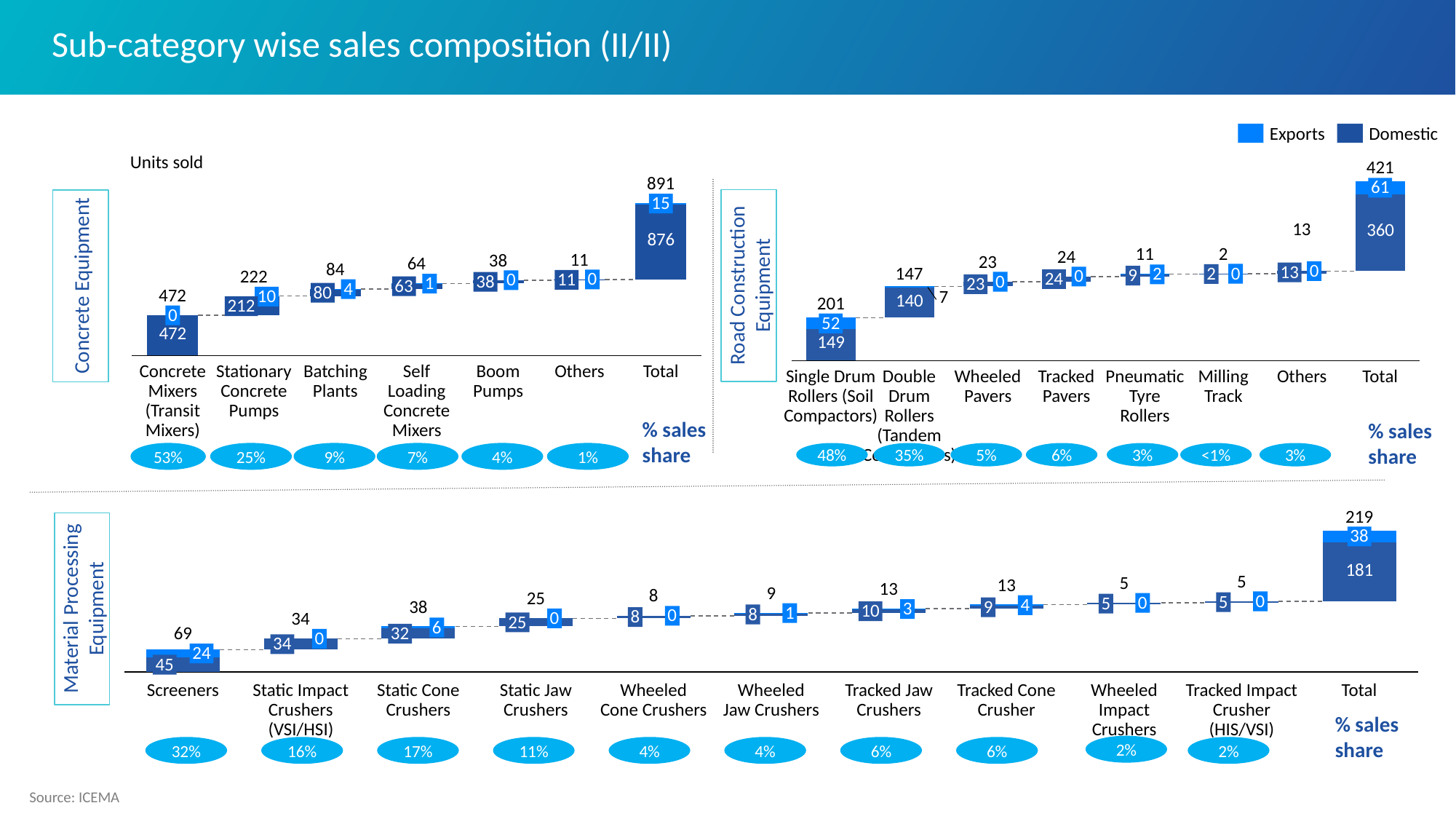
In the Material Processing Equipment chart, how many sub-categories are shown on the x axis, excluding Total? 10 In the Concrete Equipment chart, which sub-category (excluding Total) has the lowest units sold? Others In the Road Construction Equipment chart, what is the Domestic value for Single Drum Rollers (Soil Compactors)? 149 In the Material Processing Equipment chart, what is the Exports value for Screeners? 24 In the Material Processing Equipment chart, which sub-category (excluding Total) has the highest units sold? Screeners In the Concrete Equipment chart, how many units of Concrete Mixers (Transit Mixers) were sold in total? 472 In the Road Construction Equipment chart, what is the total units sold shown for the Total bar? 421 How many series does the legend list? 2 In the Concrete Equipment chart, what is the Exports value for Stationary Concrete Pumps? 10 In the Road Construction Equipment chart, which is larger in total units sold: Wheeled Pavers or Tracked Pavers? Tracked Pavers In the Concrete Equipment chart, what is the difference in total units sold between Concrete Mixers (Transit Mixers) and Stationary Concrete Pumps? 250 In the Road Construction Equipment chart, what % sales share is shown for Double Drum Rollers (Tandem Compactors)? 35%